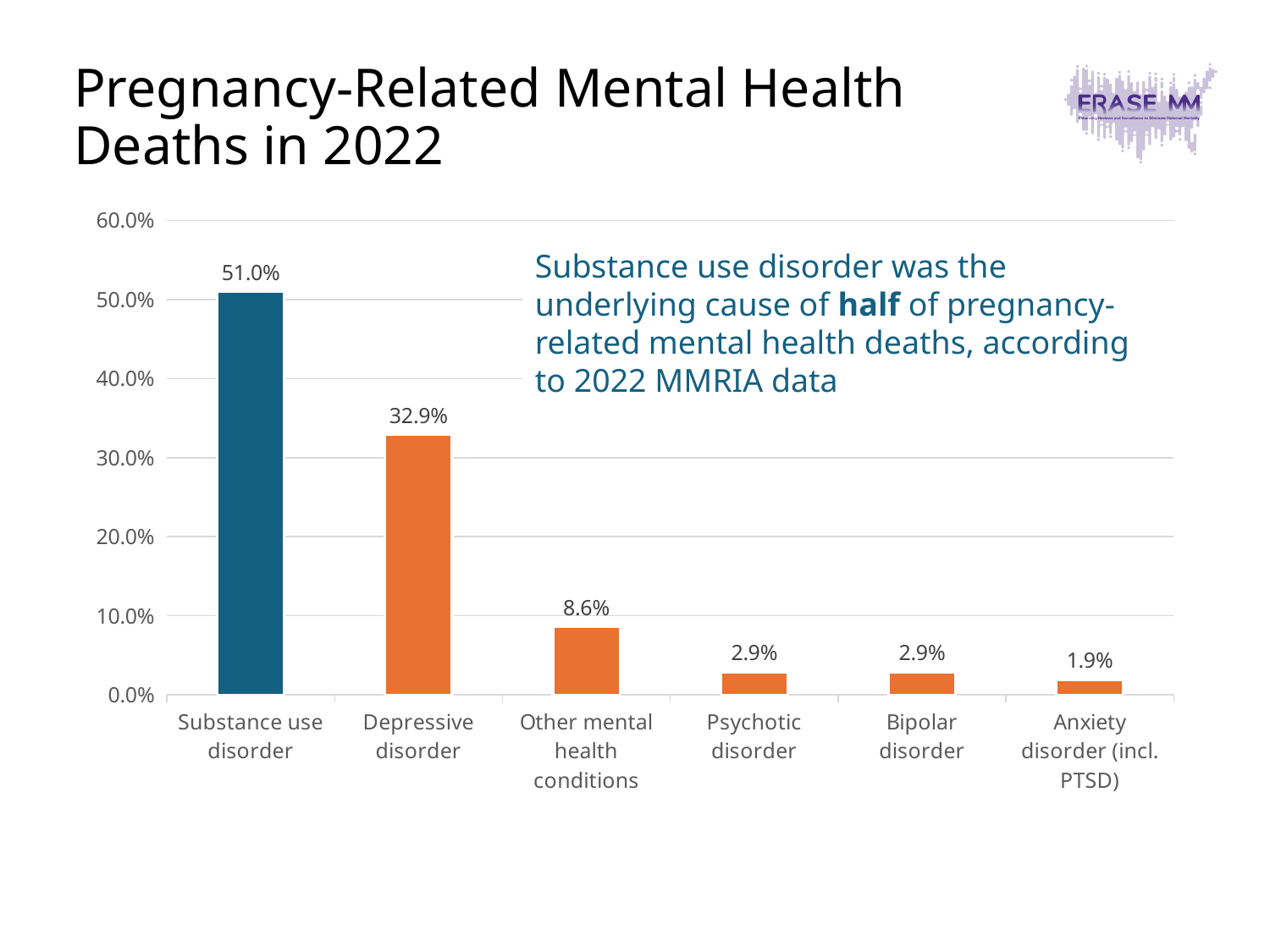
What is the value for Substance use disorder? 51.0% Is the value for Depressive disorder greater or less than 30.0%? greater What is the value for Anxiety disorder (incl. PTSD)? 1.9% What is the difference between the values for Substance use disorder and Depressive disorder? 18.1% Which category has the highest value? Substance use disorder Which bar is coloured differently from the others? Substance use disorder What is the value for Other mental health conditions? 8.6% What is the value for Depressive disorder? 32.9% What kind of chart is shown on the slide? bar chart Which is larger, the value for Other mental health conditions or the value for Psychotic disorder? Other mental health conditions Which category has the lowest value? Anxiety disorder (incl. PTSD) How many categories are shown on the x axis? 6